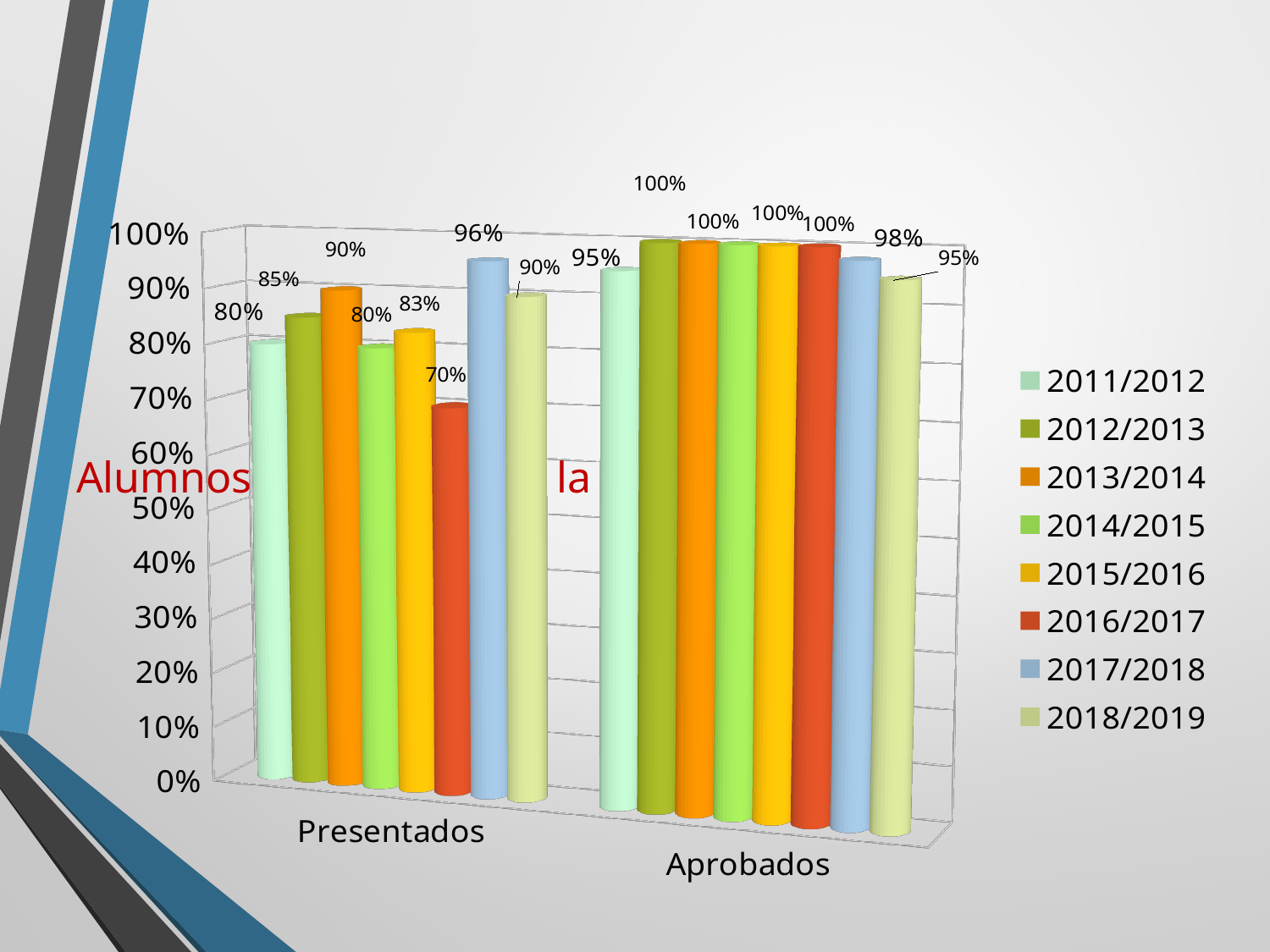
Which is larger in the Presentados category: the value for 2012/2013 or the value for 2015/2016? 2012/2013 What kind of chart is shown on the slide? Bar chart What is the value for 2016/2017 in the Presentados category? 70% What is the value for 2017/2018 in the Presentados category? 96% How many categories are shown on the x axis? 2 What is the value for 2011/2012 in the Aprobados category? 95% Which series has the highest value in the Presentados category? 2017/2018 Which series has the lowest value in the Presentados category? 2016/2017 What is the difference between the 2017/2018 and 2016/2017 values in the Presentados category? 26% What is the value for 2013/2014 in the Presentados category? 90% What colour represents the 2016/2017 series in the legend? Red-orange How many series does the legend list? 8